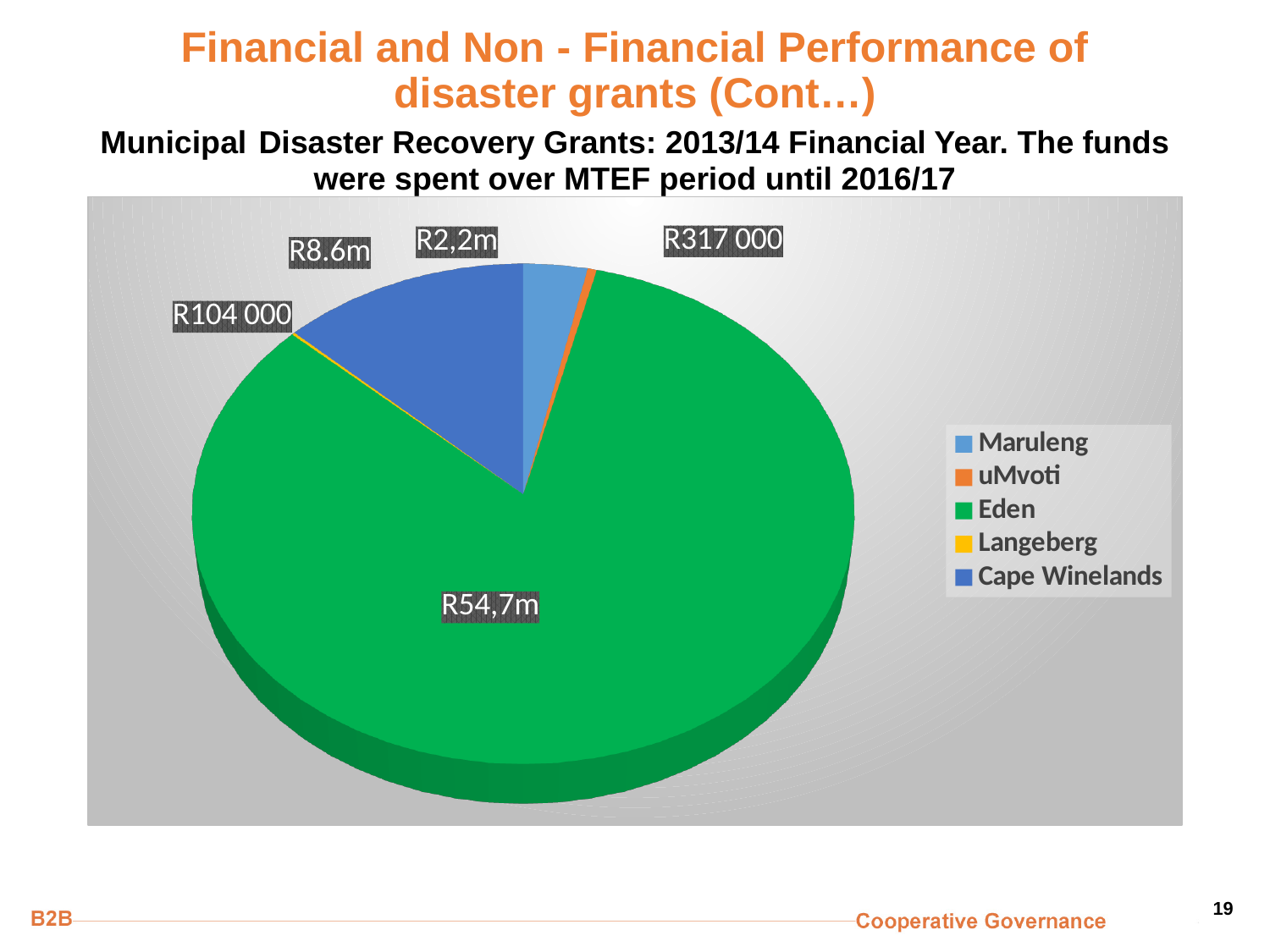
What is the value shown for Cape Winelands? R8.6m Which municipality received the smallest grant? Langeberg What colour is the Eden slice in the pie chart? Green Which municipality received the largest grant? Eden What is the value shown for Langeberg? R104 000 What kind of chart is shown on the slide? Pie chart What is the value shown for uMvoti? R317 000 Which received more, Cape Winelands or Maruleng? Cape Winelands What is the value shown for Eden? R54,7m What is the value shown for Maruleng? R2,2m How many slices does the pie chart have? 5 How many entries does the legend list? 5